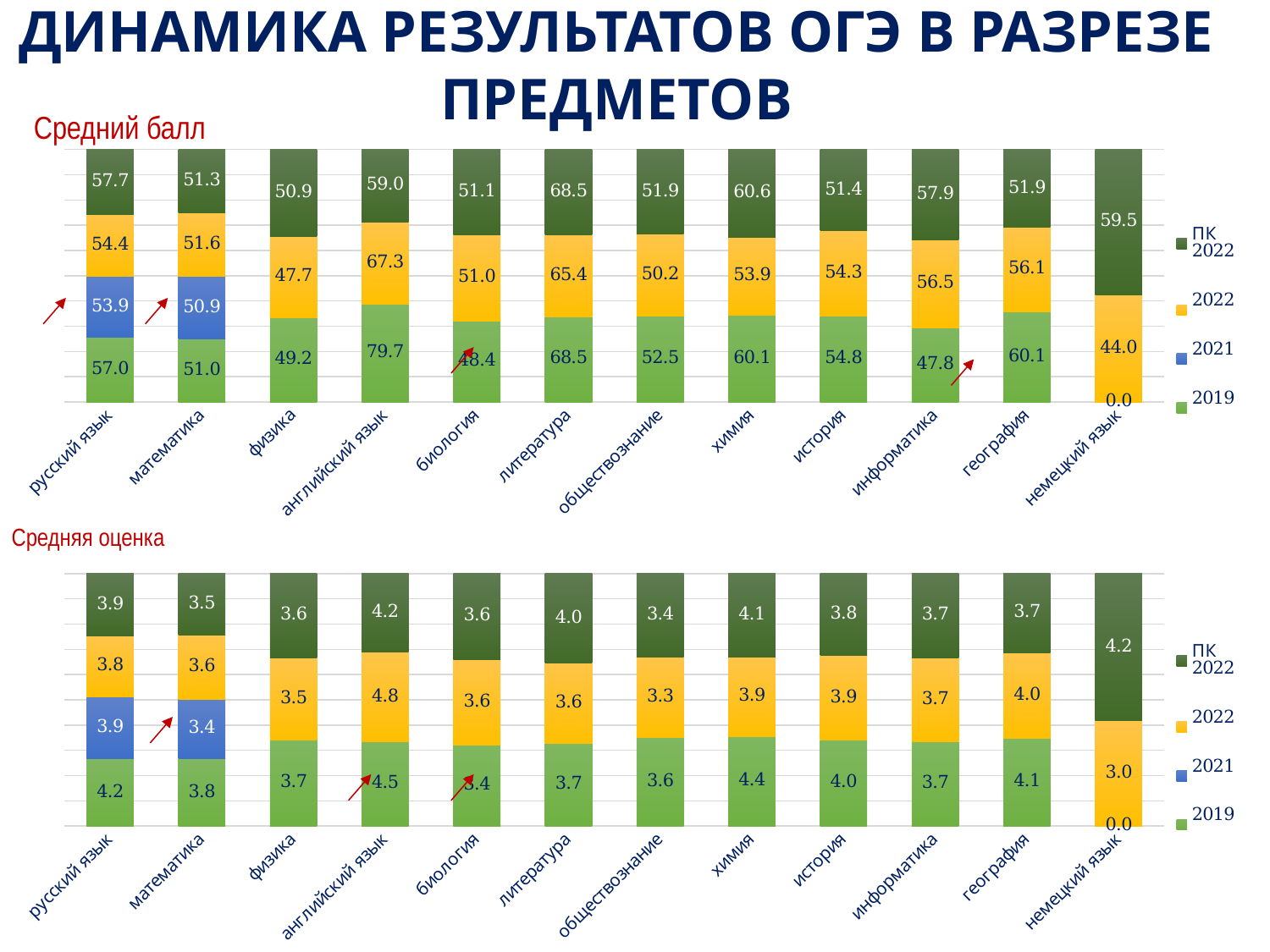
In the bottom chart (Средняя оценка), which subject has the highest 2019 value? английский язык What kind of chart is the bottom chart (Средняя оценка)? stacked bar chart In the top chart (Средний балл), what is the value for русский язык in the 2021 series? 53.9 In the top chart (Средний балл), which subject has the lowest 2022 value? немецкий язык In the top chart (Средний балл), which is larger for химия: the ПК 2022 value or the 2022 value? ПК 2022 In the top chart (Средний балл), which subject has the highest 2019 value? английский язык How many series does the legend of the bottom chart (Средняя оценка) list? 4 In the top chart (Средний балл), what is the difference between the 2019 and 2022 values for география? 4.0 In the bottom chart (Средняя оценка), what is the 2022 value for английский язык? 4.8 In the bottom chart (Средняя оценка), what is the difference between the 2019 and 2021 values for математика? 0.4 In the top chart (Средний балл), what is the ПК 2022 value for информатика? 57.9 How many subjects are shown on the x axis of the top chart (Средний балл)? 12